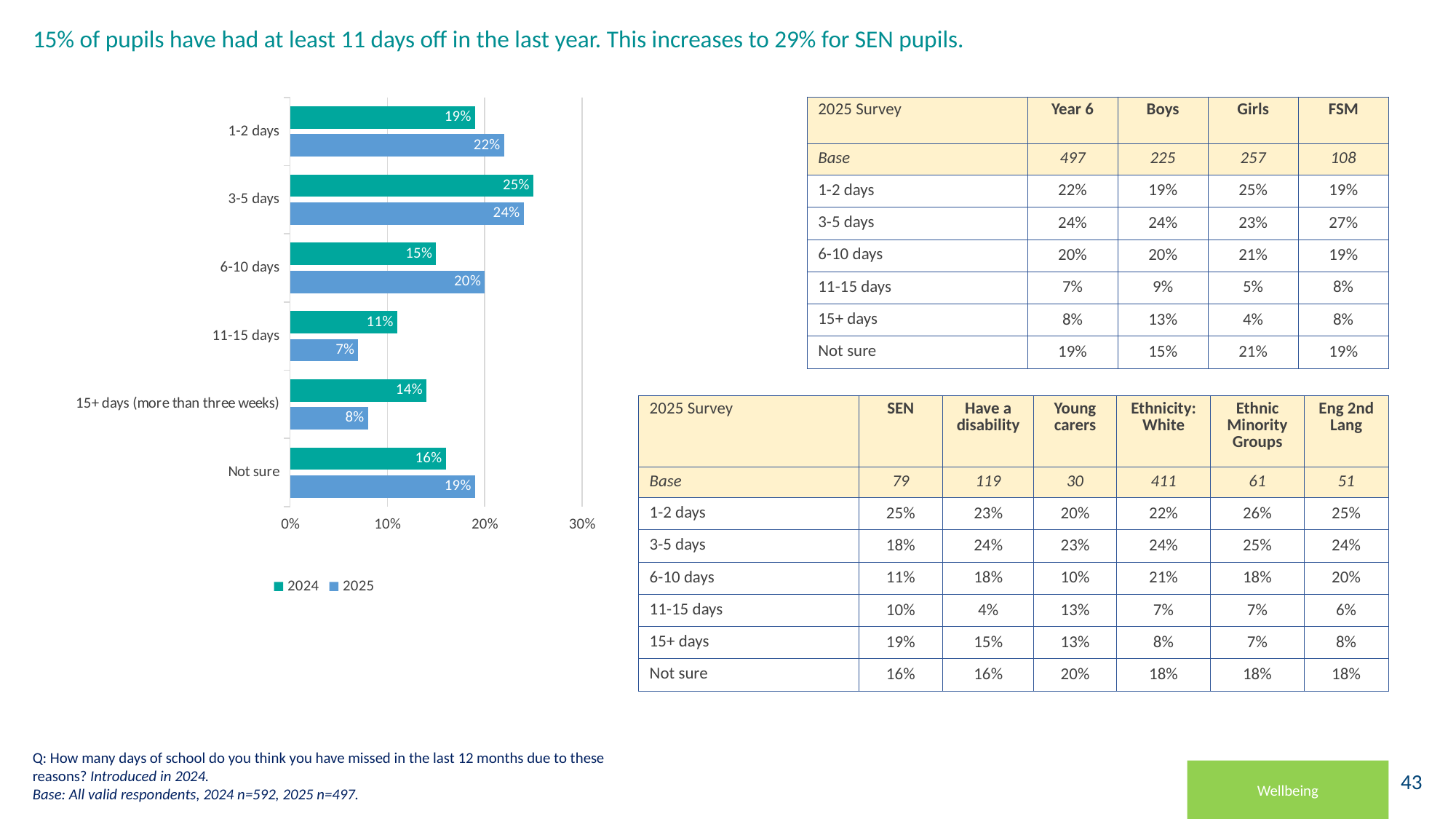
In the bar chart, is the 2024 or the 2025 value larger for 11-15 days? 2024 What is the 2025 value for 11-15 days in the bar chart? 7% In the bar chart, is the 2024 or the 2025 value larger for 1-2 days? 2025 Which category has the lowest 2024 value in the bar chart? 11-15 days Which category has the lowest 2025 value in the bar chart? 11-15 days How many series does the legend of the bar chart list? 2 What is the 2024 value for 3-5 days in the bar chart? 25% What is the difference between the 2024 and 2025 values for 15+ days (more than three weeks) in the bar chart? 6% Which category has the highest 2025 value in the bar chart? 3-5 days What kind of chart is shown on the slide? Bar chart How many categories are shown in the bar chart? 6 What is the 2025 value for 6-10 days in the bar chart? 20%